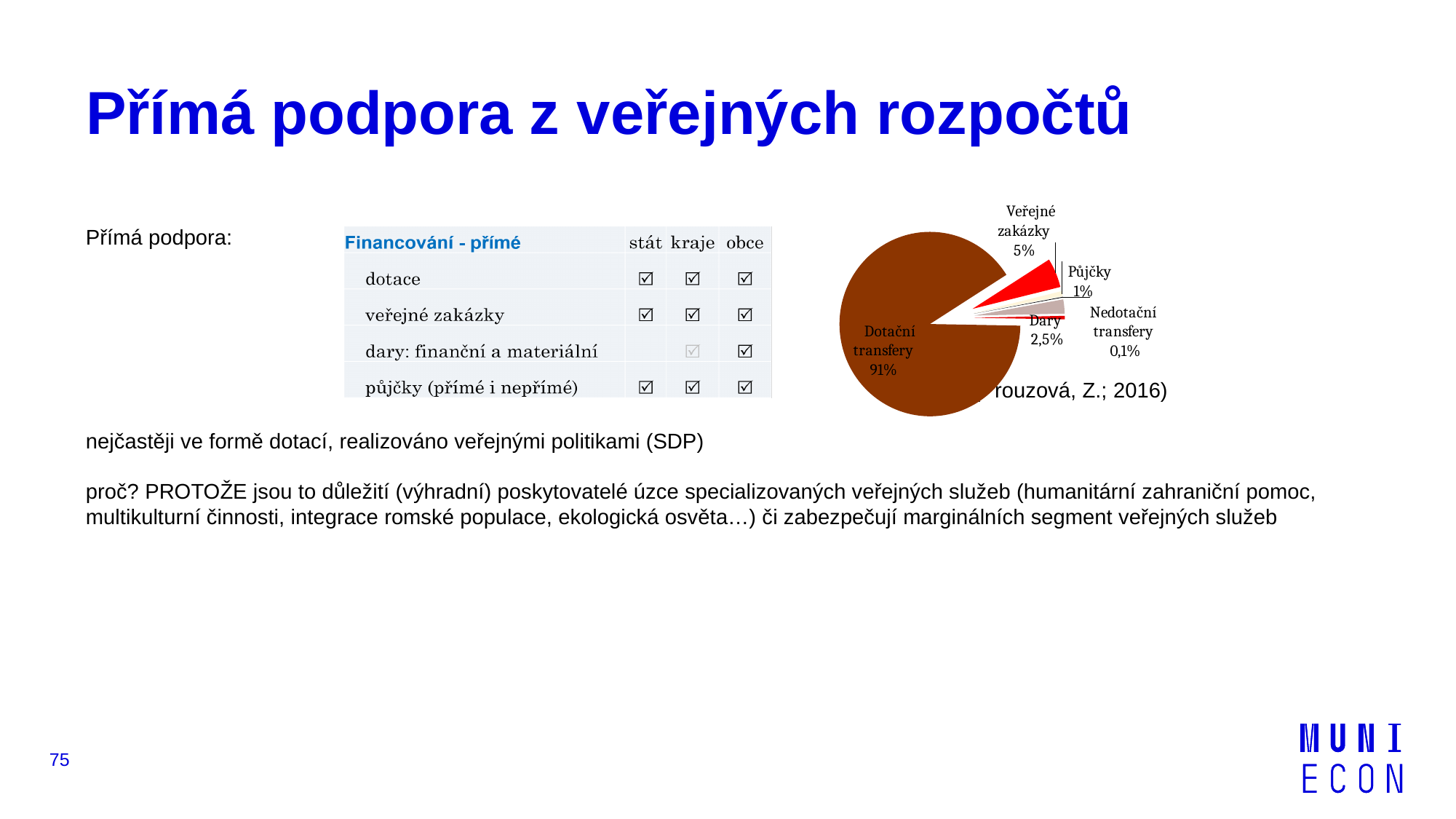
What share of the pie does Nedotační transfery have? 0,1% Which is larger in the pie chart, Veřejné zakázky or Dary? Veřejné zakázky What kind of chart is shown on the slide? pie chart What share of the pie does Půjčky have? 1% What share of the pie does Veřejné zakázky have? 5% How many slices does the pie chart have? 6 Which slice of the pie chart is the largest? Dotační transfery What is the difference in percentage points between Dotační transfery and Veřejné zakázky? 86 What is the difference in percentage points between Dary and Půjčky? 1,5 Which slice of the pie chart is the smallest? Nedotační transfery